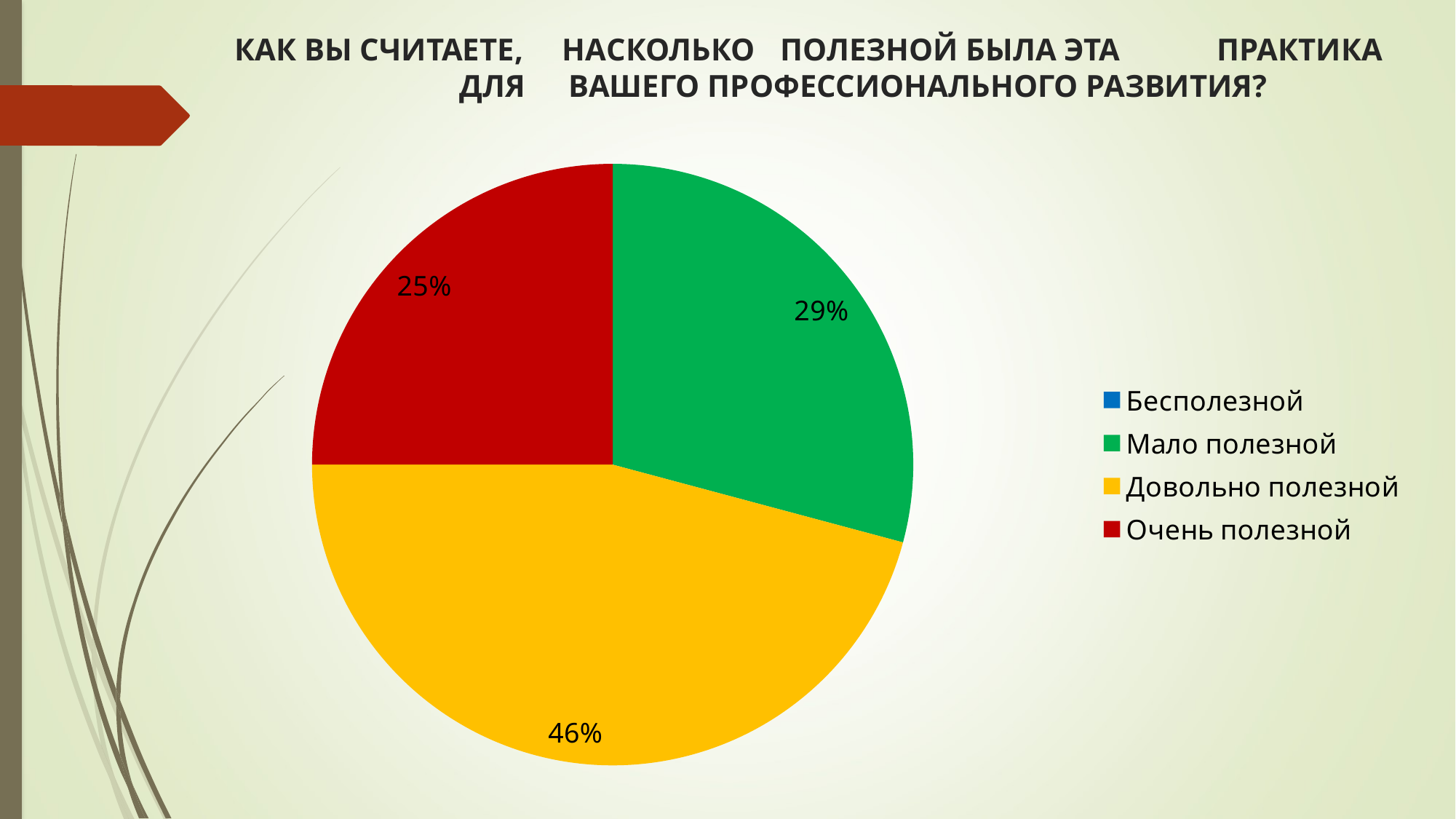
What is the difference between the "Довольно полезной" and "Мало полезной" slices? 17% What percentage is shown for the "Очень полезной" slice? 25% What percentage is shown for the "Довольно полезной" slice? 46% How many entries does the legend list? 4 What percentage is shown for the "Мало полезной" slice? 29% What colour is the "Довольно полезной" slice? yellow What kind of chart is shown on the slide? pie chart What is the difference between the "Мало полезной" and "Очень полезной" slices? 4% Which category has the largest slice of the pie? Довольно полезной Which is larger, the "Мало полезной" slice or the "Очень полезной" slice? Мало полезной Which labelled slice is the smallest? Очень полезной How many slices with data labels are visible in the pie? 3